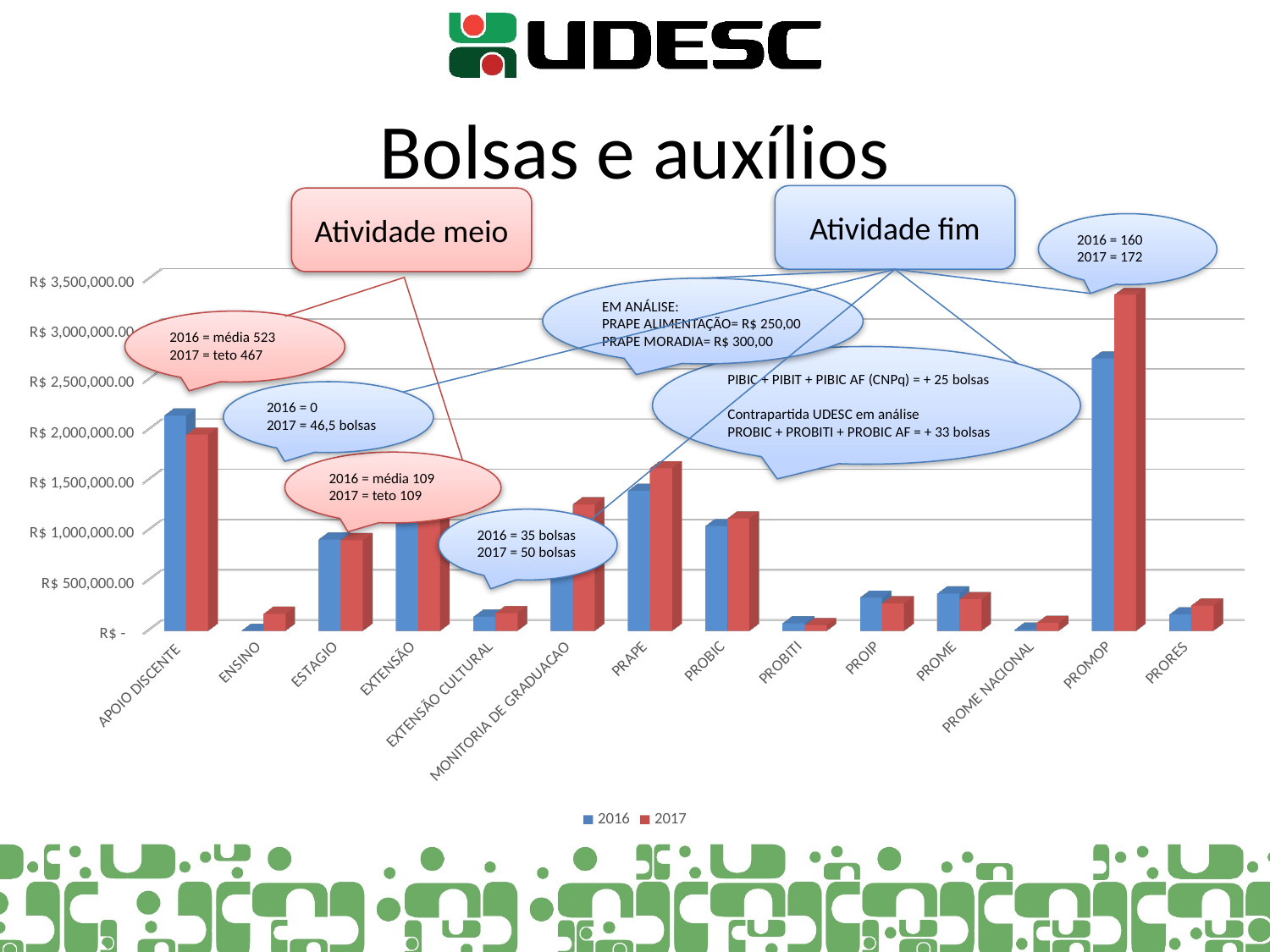
What kind of chart is shown on the slide? Bar chart Which colour represents the 2017 series in the chart? Red Is the 2016 value for PROIP greater or less than R$ 500,000.00? less Is the 2017 value for PROMOP greater or less than R$ 3,000,000.00? greater How many categories are shown on the x axis of the chart? 14 Which category has the highest bar in the chart? PROMOP How many series does the chart legend list? 2 Is the 2017 value for PRAPE greater or less than R$ 1,000,000.00? greater What is the title of the slide containing the chart? Bolsas e auxílios For APOIO DISCENTE, which series has the larger value, 2016 or 2017? 2016 For PROMOP, which series has the larger value, 2016 or 2017? 2017